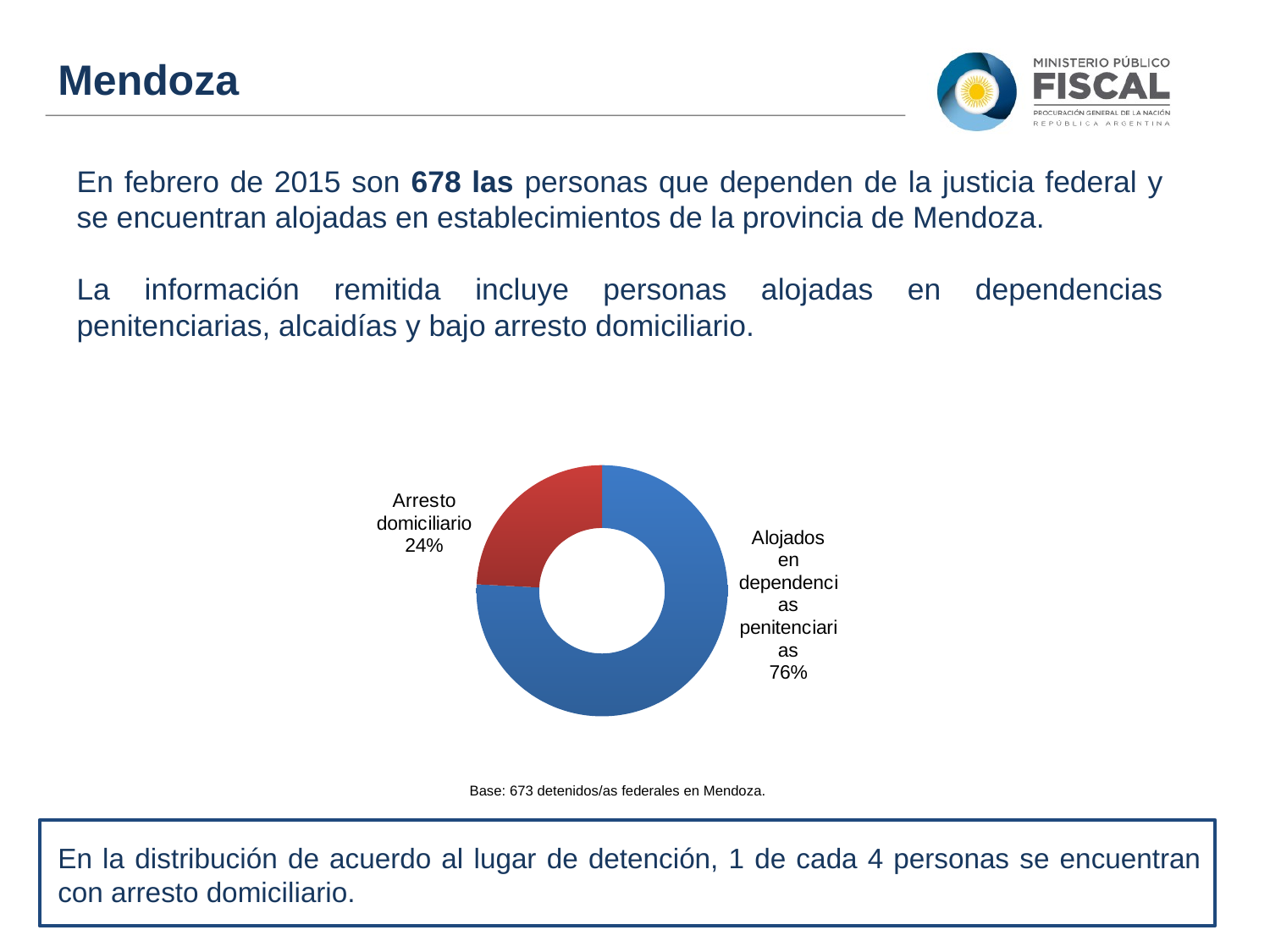
What is the difference in percentage points between 'Alojados en dependencias penitenciarias' and 'Arresto domiciliario'? 52 Which category has the smallest slice of the chart? Arresto domiciliario What share of the pie does 'Alojados en dependencias penitenciarias' represent? 76% What kind of chart is shown on the slide? Pie chart (doughnut) What colour is the 'Arresto domiciliario' slice? Red Which is larger: the share for 'Arresto domiciliario' or the share for 'Alojados en dependencias penitenciarias'? Alojados en dependencias penitenciarias Is the share for 'Arresto domiciliario' greater or less than 50%? less What colour is the 'Alojados en dependencias penitenciarias' slice? Blue Which category has the largest slice of the chart? Alojados en dependencias penitenciarias How many categories are shown in the chart? 2 What share of the pie does 'Arresto domiciliario' represent? 24%